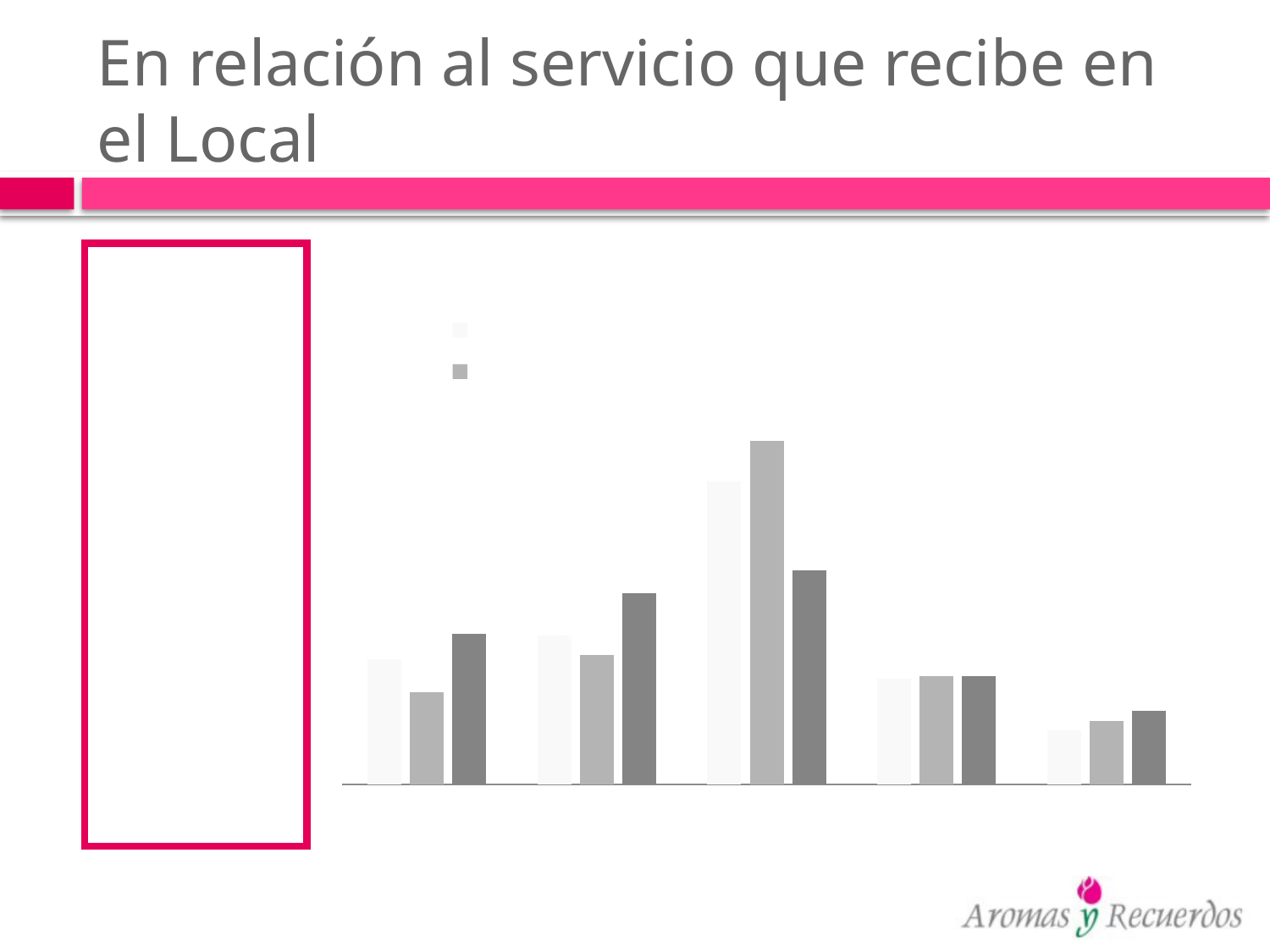
In the fifth group from the left, which bar is the shortest? the left (lightest) bar What is the title of the slide containing the chart? En relación al servicio que recibe en el Local How many groups of bars are plotted along the x axis? 5 Do the bar heights rise or fall from the third group to the fifth group along the x axis? fall What kind of chart is shown on the slide? bar chart In the first group from the left, which bar is taller: the light grey middle bar or the dark grey right bar? the dark grey right bar Counting from the left, which group of bars contains the tallest bar on the chart? the third group In the third group from the left, which bar is taller: the light grey middle bar or the dark grey right bar? the light grey middle bar How many bars are there in each group? 3 Counting from the left, which group of bars contains the shortest bar on the chart? the fifth group